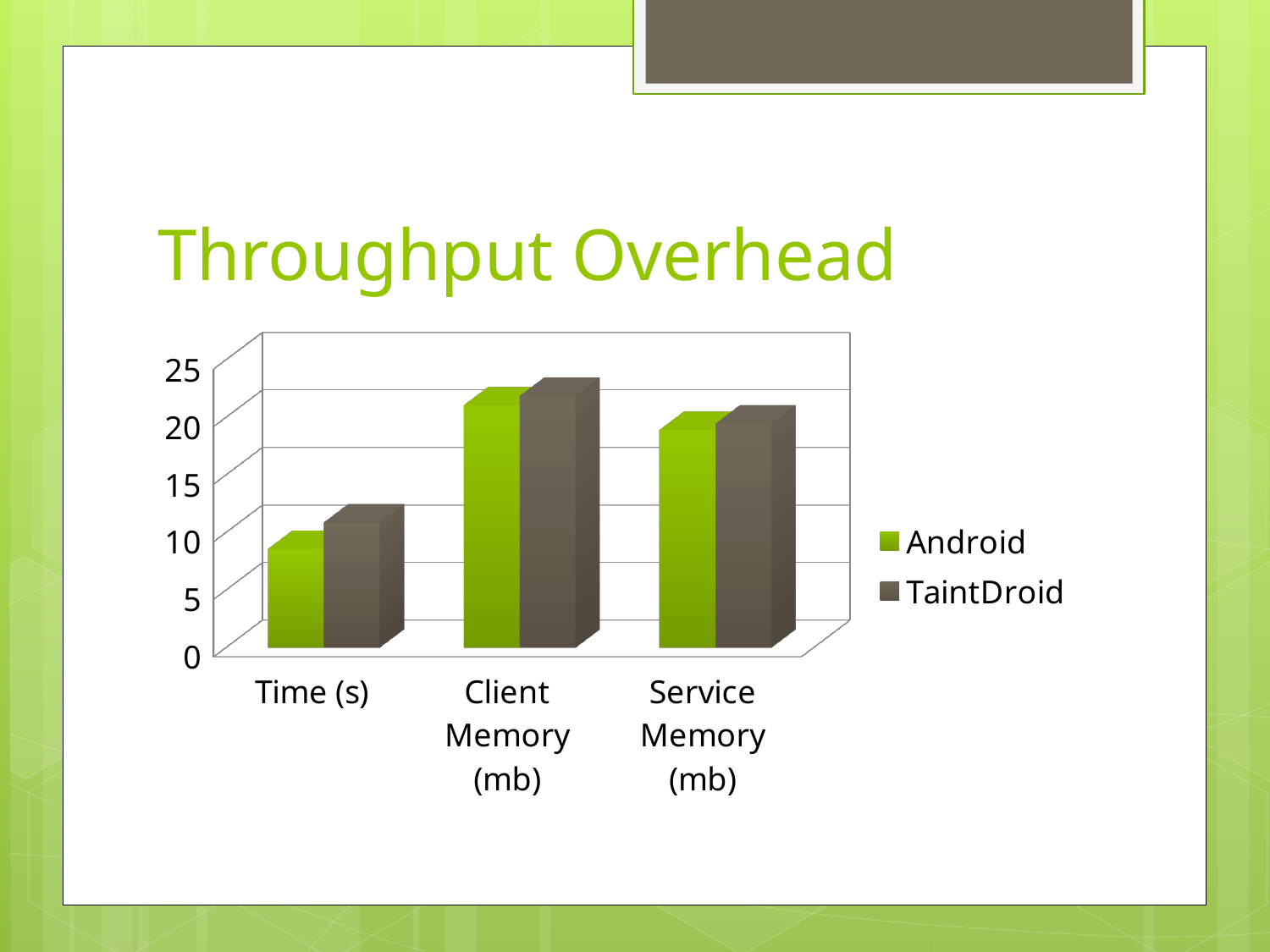
Is the Android value for Client Memory (mb) greater or less than 20? greater Which series are listed in the legend? Android and TaintDroid What is the title of the chart on the slide? Throughput Overhead Is the Android value for Time (s) greater or less than 15? less How many series does the legend list? 2 For Time (s), which series has the larger value, Android or TaintDroid? TaintDroid How many categories are shown on the x axis? 3 Is the TaintDroid value for Time (s) greater or less than 10? greater Which category has the lowest value for the TaintDroid series? Time (s) What kind of chart is shown on the slide? bar chart Which category has the highest value for the Android series? Client Memory (mb)